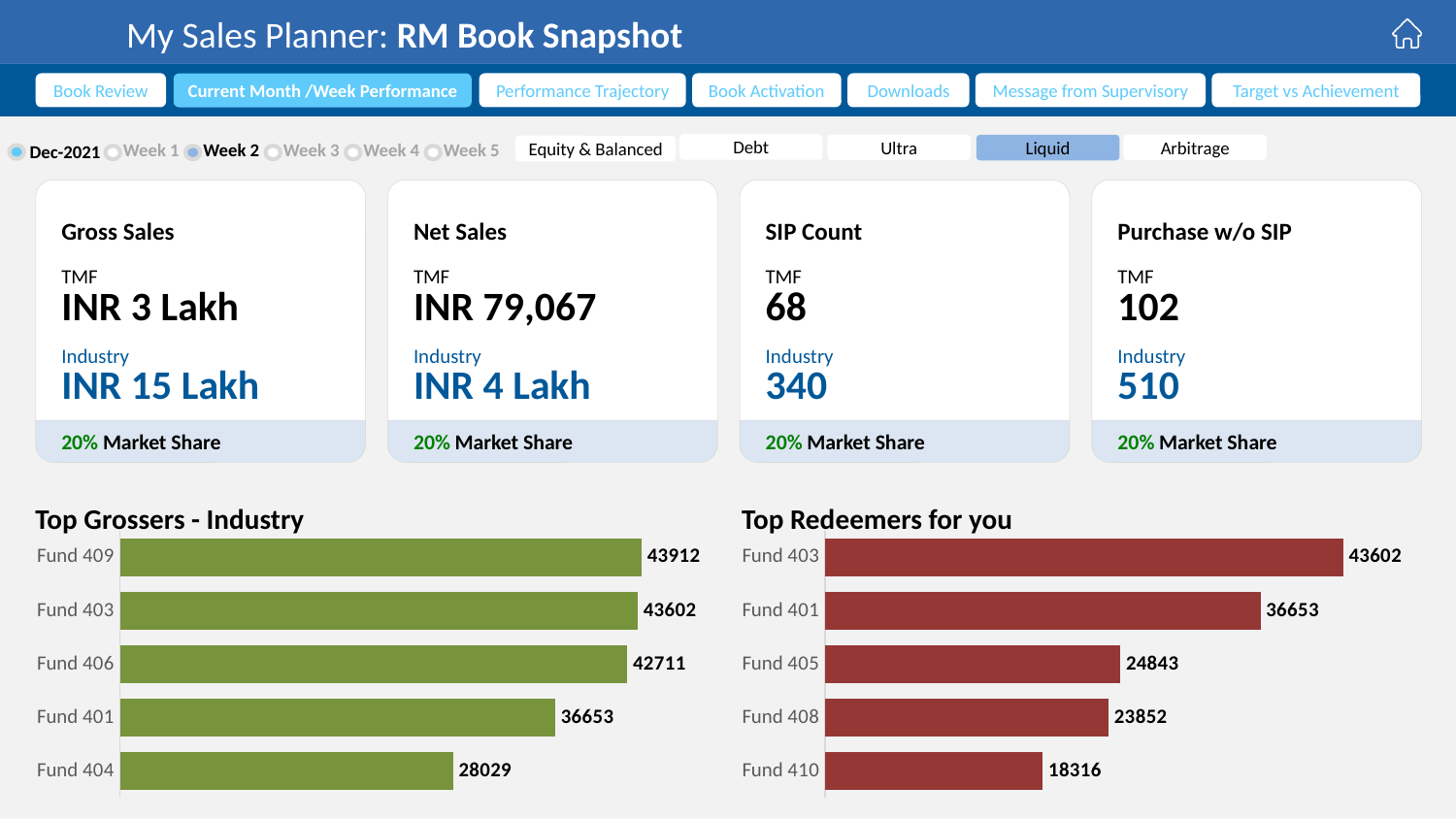
In the 'Top Redeemers for you' chart, which fund has the highest value? Fund 403 In the 'Top Grossers - Industry' chart, what is the value for Fund 406? 42711 In the 'Top Grossers - Industry' chart, how many funds are shown? 5 In the 'Top Grossers - Industry' chart, which fund has the lowest value? Fund 404 In the 'Top Grossers - Industry' chart, what is the difference between the values for Fund 409 and Fund 401? 7259 In the 'Top Redeemers for you' chart, what is the value for Fund 405? 24843 In the 'Top Redeemers for you' chart, which is larger, the value for Fund 408 or Fund 410? Fund 408 In the 'Top Redeemers for you' chart, what is the value for Fund 410? 18316 What type of chart is 'Top Redeemers for you'? Bar chart In the 'Top Grossers - Industry' chart, what is the value for Fund 404? 28029 In the 'Top Grossers - Industry' chart, which fund has the highest value? Fund 409 In the 'Top Redeemers for you' chart, what is the difference between the values for Fund 403 and Fund 401? 6949